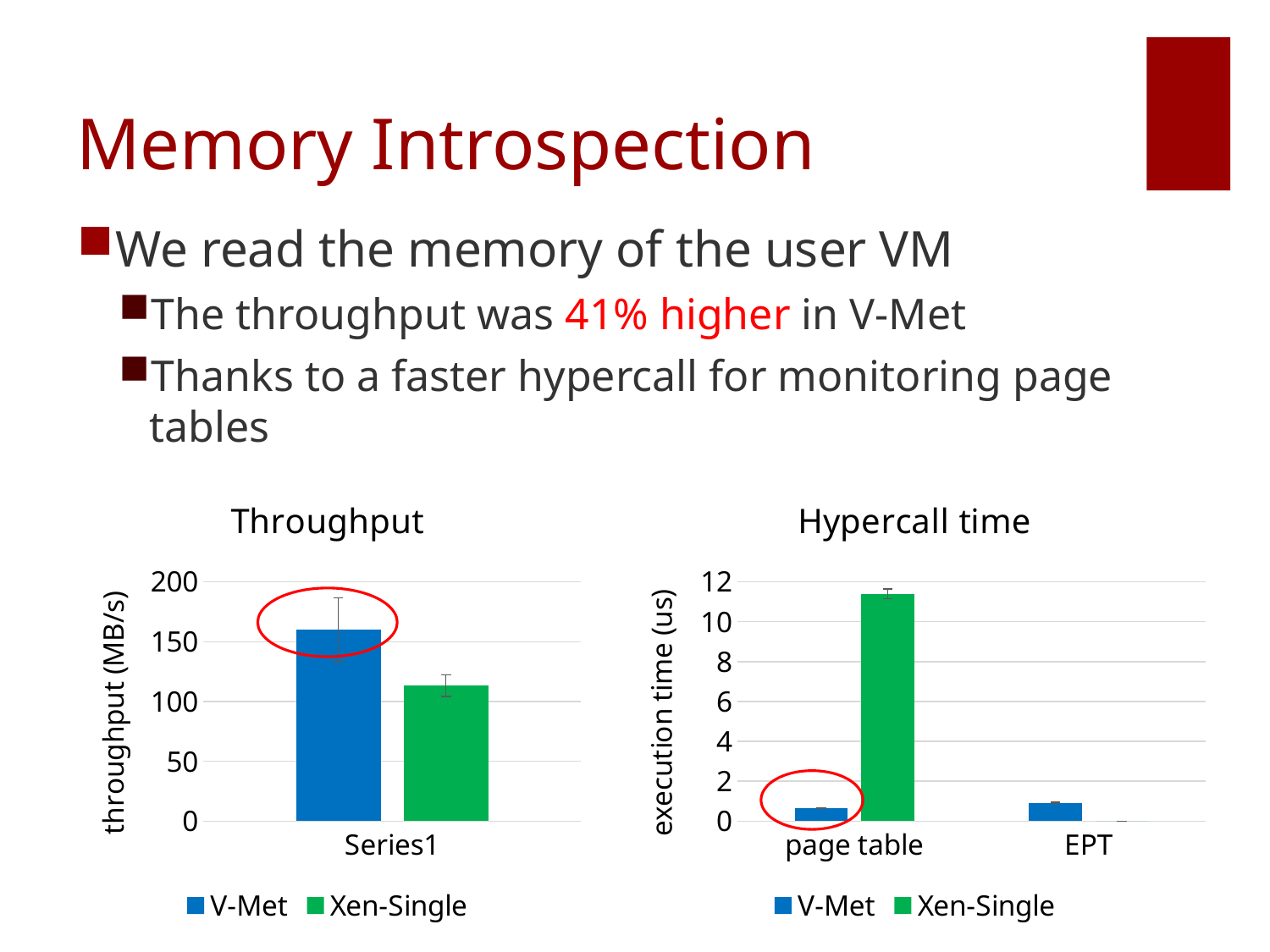
In the Throughput chart, is the value for Xen-Single greater or less than 100? greater In the Throughput chart, is the value for V-Met greater or less than 150? greater How many series does the legend of the Throughput chart list? 2 In the Throughput chart, which series has the higher bar, V-Met or Xen-Single? V-Met What is the y-axis label of the Hypercall time chart? execution time (us) In the Throughput chart, is the value for Xen-Single greater or less than 150? less In the Hypercall time chart, which series has the higher bar for page table, V-Met or Xen-Single? Xen-Single How many categories are shown on the x axis of the Hypercall time chart? 2 What kind of chart is the Throughput chart? bar chart What is the y-axis label of the Throughput chart? throughput (MB/s)